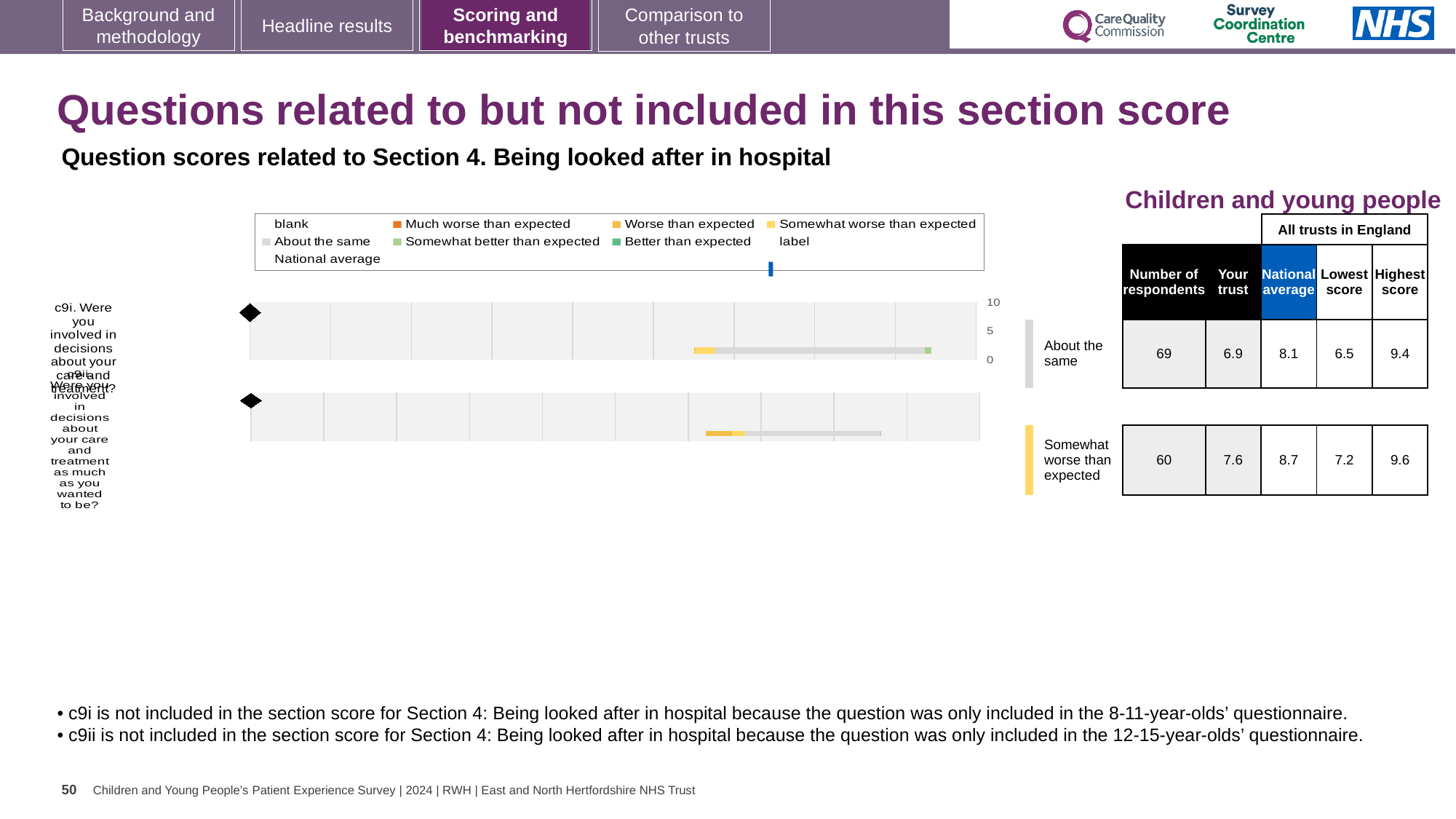
What is the highest value shown on the chart's score axis? 10 According to the table, how many respondents answered question c9i? 69 Which benchmark category is shown for question c9i? About the same How many questions (categories) are plotted in the chart? 2 According to the table, what is the 'Your trust' score for question c9ii? 7.6 What is the difference between the national average and the 'Your trust' score for question c9i? 1.2 According to the table, what is the national average score for question c9i? 8.1 What kind of chart is used to show the question scores for c9i and c9ii? bar chart Which benchmark category is shown for question c9ii? Somewhat worse than expected What is the lowest score among all trusts in England for question c9ii? 7.2 Which question had more respondents, c9i or c9ii? c9i According to the table, what is the highest score among all trusts in England for question c9ii? 9.6